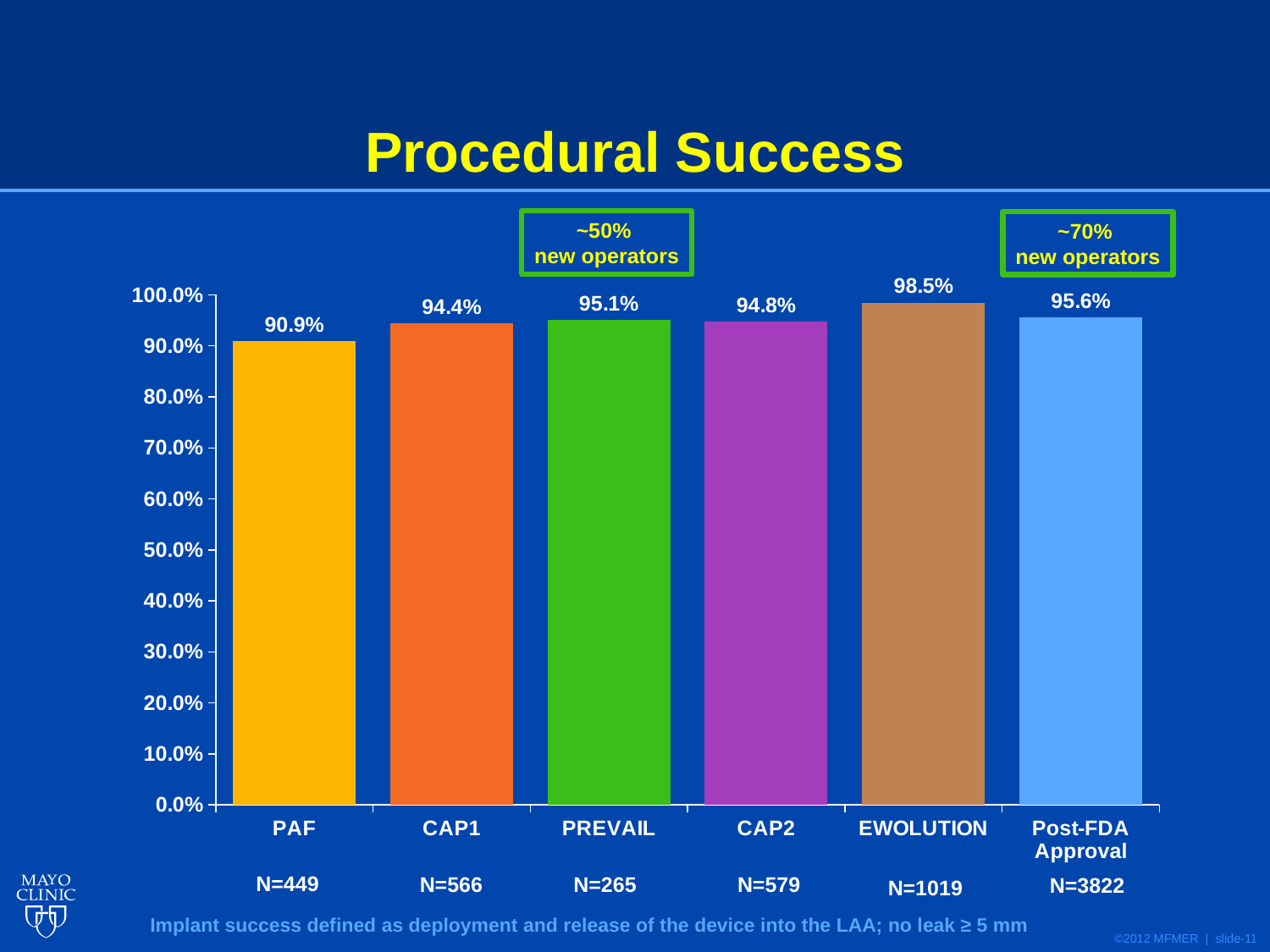
Which category has the highest procedural success? EWOLUTION What is the difference between the EWOLUTION and PAF values? 7.6% What is the title of the chart? Procedural Success What is the procedural success value for EWOLUTION? 98.5% Is the value for PAF greater or less than 90.0%? greater What is the difference between the Post-FDA Approval and CAP1 values? 1.2% What is the procedural success value for Post-FDA Approval? 95.6% What is the procedural success value for PAF? 90.9% How many categories are shown on the x axis? 6 Which is larger, the value for PREVAIL or the value for CAP2? PREVAIL Which category has the lowest procedural success? PAF What kind of chart is shown on the slide? bar chart